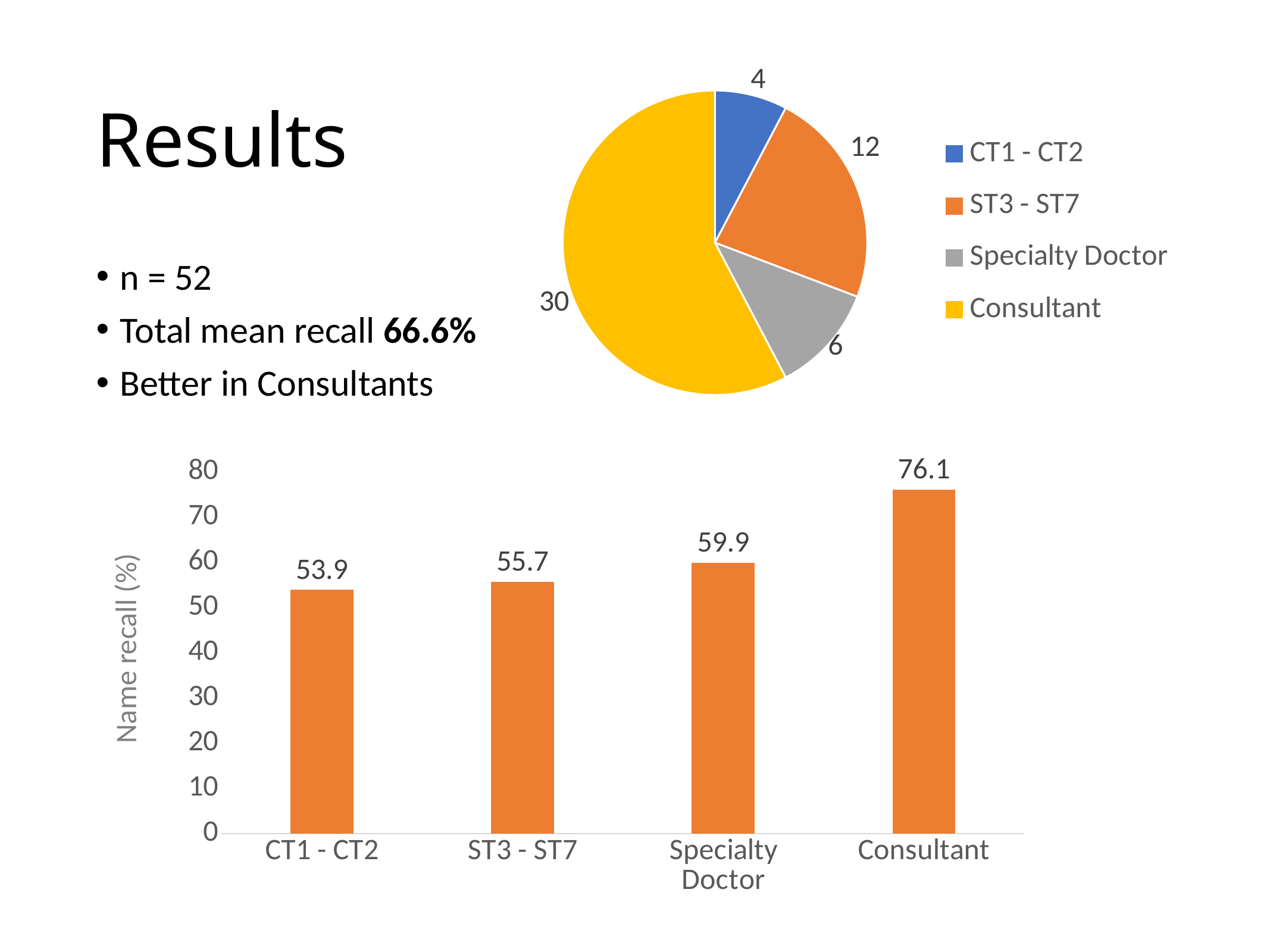
In the pie chart at the top of the slide, what colour is the Specialty Doctor slice? Grey In the bar chart at the bottom of the slide, which category has the highest name recall? Consultant In the pie chart at the top of the slide, what is the value for Consultant? 30 In the bar chart at the bottom of the slide, what is the name recall value for Specialty Doctor? 59.9 In the pie chart at the top of the slide, what is the total of all slice values? 52 In the pie chart at the top of the slide, which category has the smallest slice? CT1 - CT2 In the bar chart at the bottom of the slide, which category has the lowest name recall? CT1 - CT2 In the pie chart at the top of the slide, how many categories does the legend list? 4 In the bar chart at the bottom of the slide, what is the difference between the Consultant and CT1 - CT2 values? 22.2 In the bar chart at the bottom of the slide, do the values rise or fall from left to right? Rise In the pie chart at the top of the slide, what is the value for ST3 - ST7? 12 What kind of chart is shown at the bottom of the slide? Bar chart